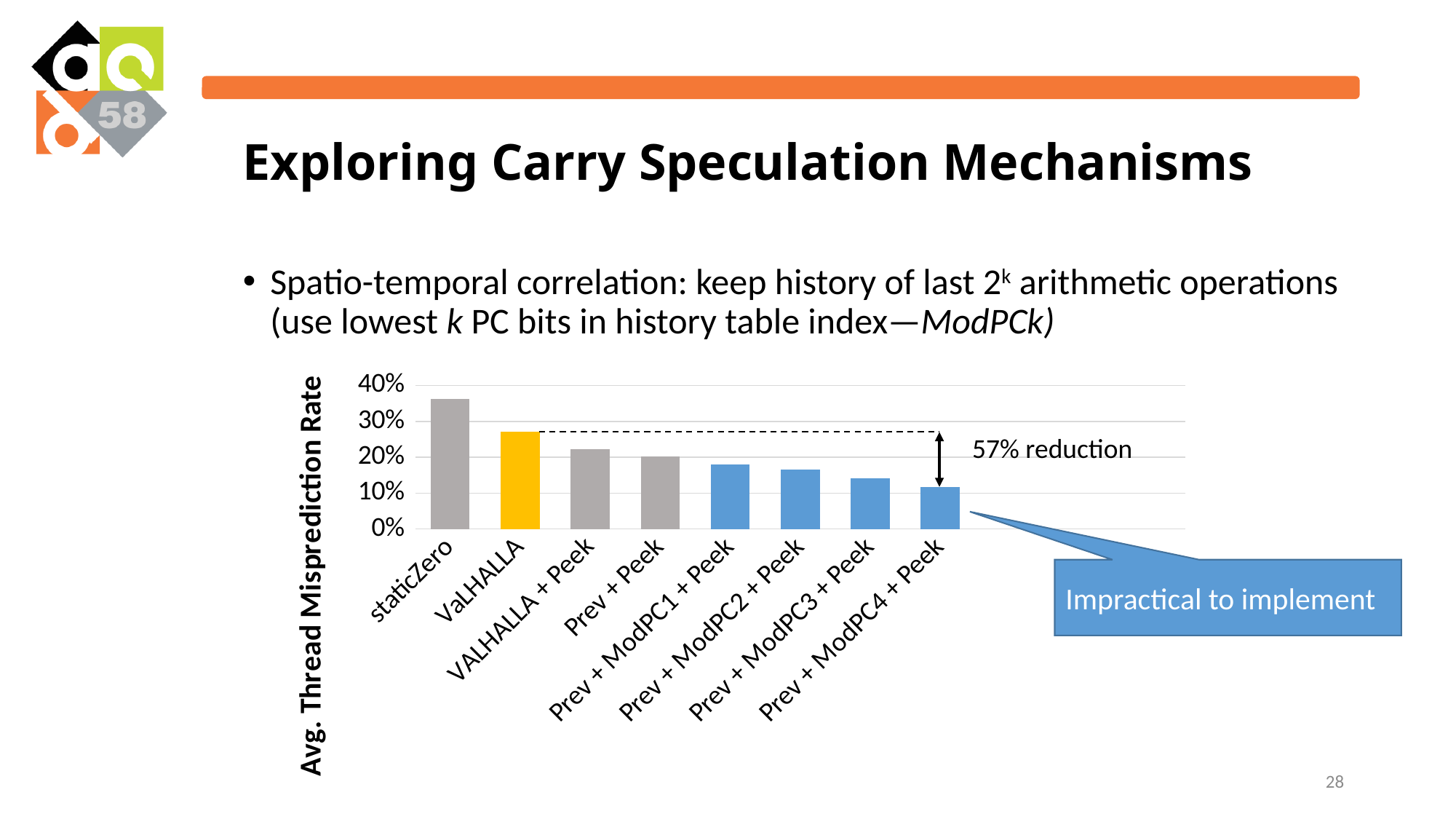
What is the label of the vertical axis? Avg. Thread Misprediction Rate Which category has the lowest average thread misprediction rate? Prev + ModPC4 + Peek How many categories (bars) does the chart show? 8 What reduction does the annotation on the chart state? 57% reduction Is the value for staticZero greater or less than 30%? greater Is the value for Prev + ModPC3 + Peek greater or less than 20%? less Which has a higher misprediction rate, staticZero or VALHALLA? staticZero Which category has the highest average thread misprediction rate? staticZero Is the value for VALHALLA greater or less than 20%? greater What kind of chart is shown on the slide? bar chart Do the bar values rise or fall from left to right along the x axis? fall